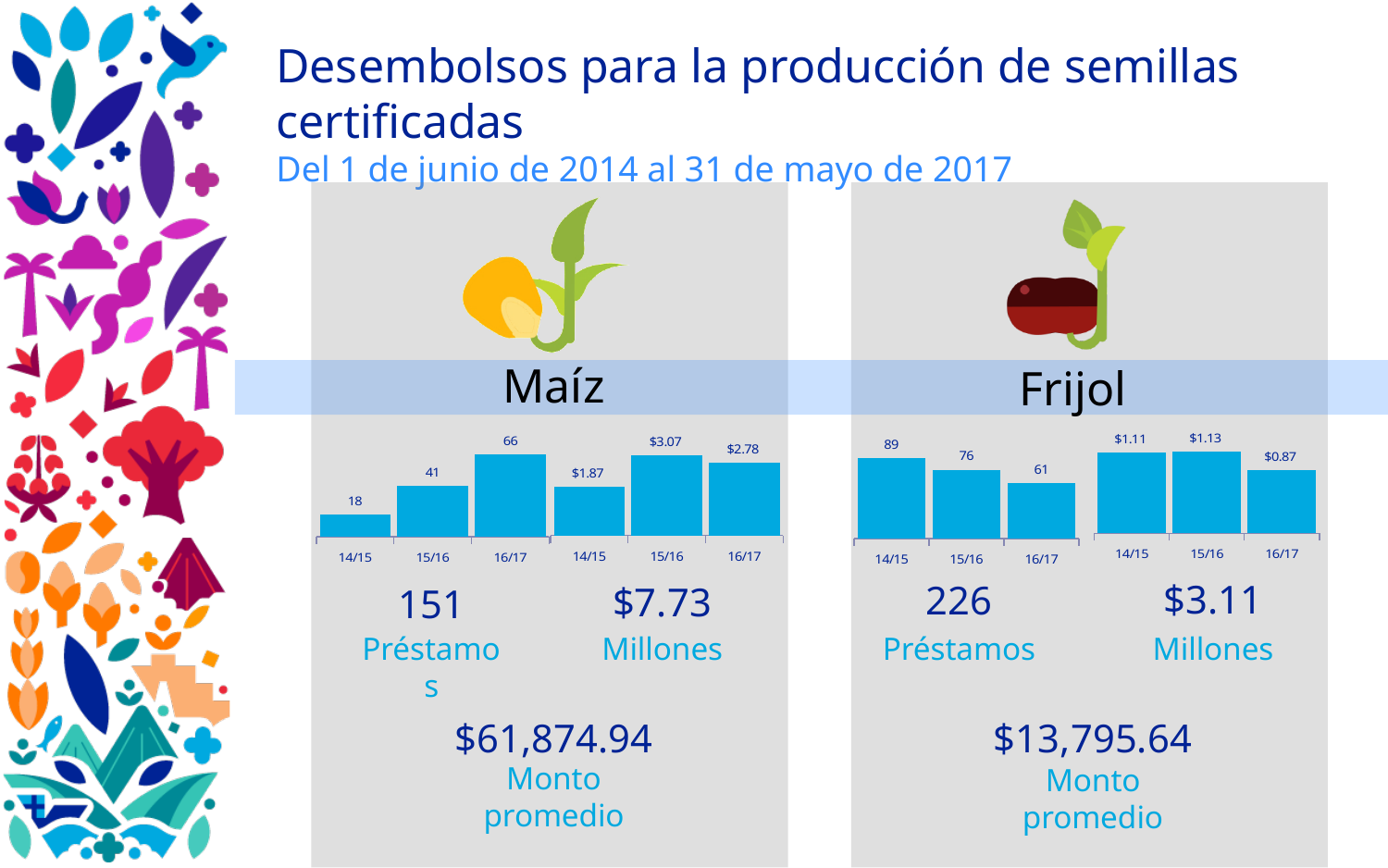
In the Frijol loan-count bar chart (left chart under Frijol), what is the difference between 14/15 and 16/17? 28 How many periods are shown in the Maíz loan-count bar chart (left chart under Maíz)? 3 In the Maíz loan-count bar chart (left chart under Maíz), what is the value for 16/17? 66 In the Frijol amount bar chart (right chart under Frijol), what is the value for 16/17? $0.87 In the Frijol loan-count bar chart (left chart under Frijol), what is the value for 14/15? 89 In the Maíz amount bar chart (right chart under Maíz), what is the value for 15/16? $3.07 In the Maíz loan-count bar chart (left chart under Maíz), what is the difference between 16/17 and 14/15? 48 In the Maíz loan-count bar chart (left chart under Maíz), which period has the lowest value? 14/15 In the Maíz amount bar chart (right chart under Maíz), which period has the highest value? 15/16 In the Frijol loan-count bar chart (left chart under Frijol), do the values rise or fall from 14/15 to 16/17? fall In the Frijol amount bar chart (right chart under Frijol), which is larger, 14/15 or 16/17? 14/15 In the Maíz loan-count bar chart (left chart under Maíz), do the values rise or fall from 14/15 to 16/17? rise